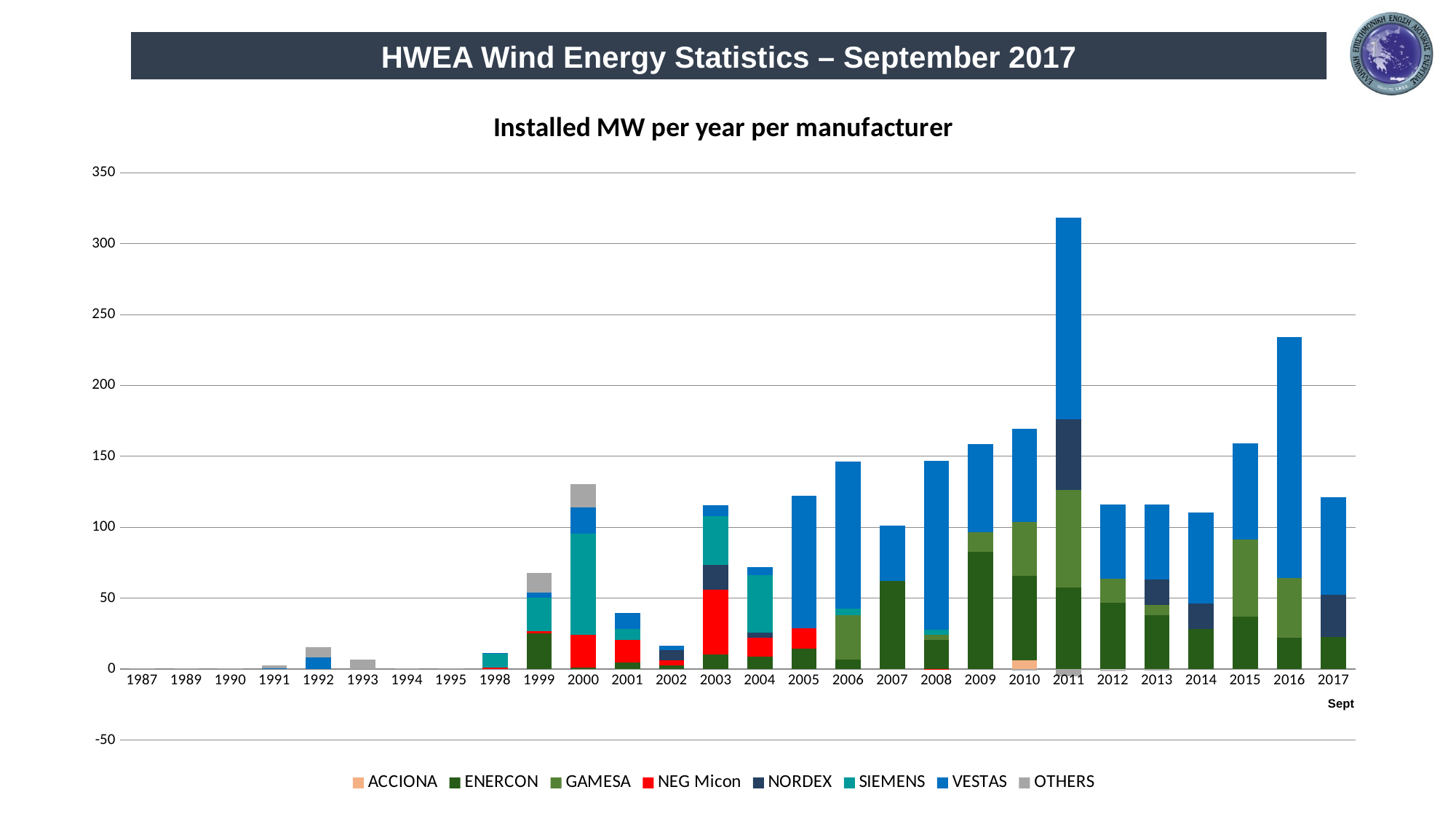
How many years are shown along the x axis? 28 Is the total installed MW for 2011 greater or less than 300? greater Is the total installed MW for 2016 greater or less than 200? greater Which year has a larger total installed MW, 2007 or 2009? 2009 Which year has the highest total installed MW? 2011 Do the total installed MW values rise or fall from 2007 to 2011? rise Is the total installed MW for 2001 greater or less than 50? less Which year has a larger total installed MW, 2015 or 2016? 2016 How many manufacturers (series) does the legend list? 8 What is the title of the chart? Installed MW per year per manufacturer What kind of chart is shown on the slide? Stacked bar chart